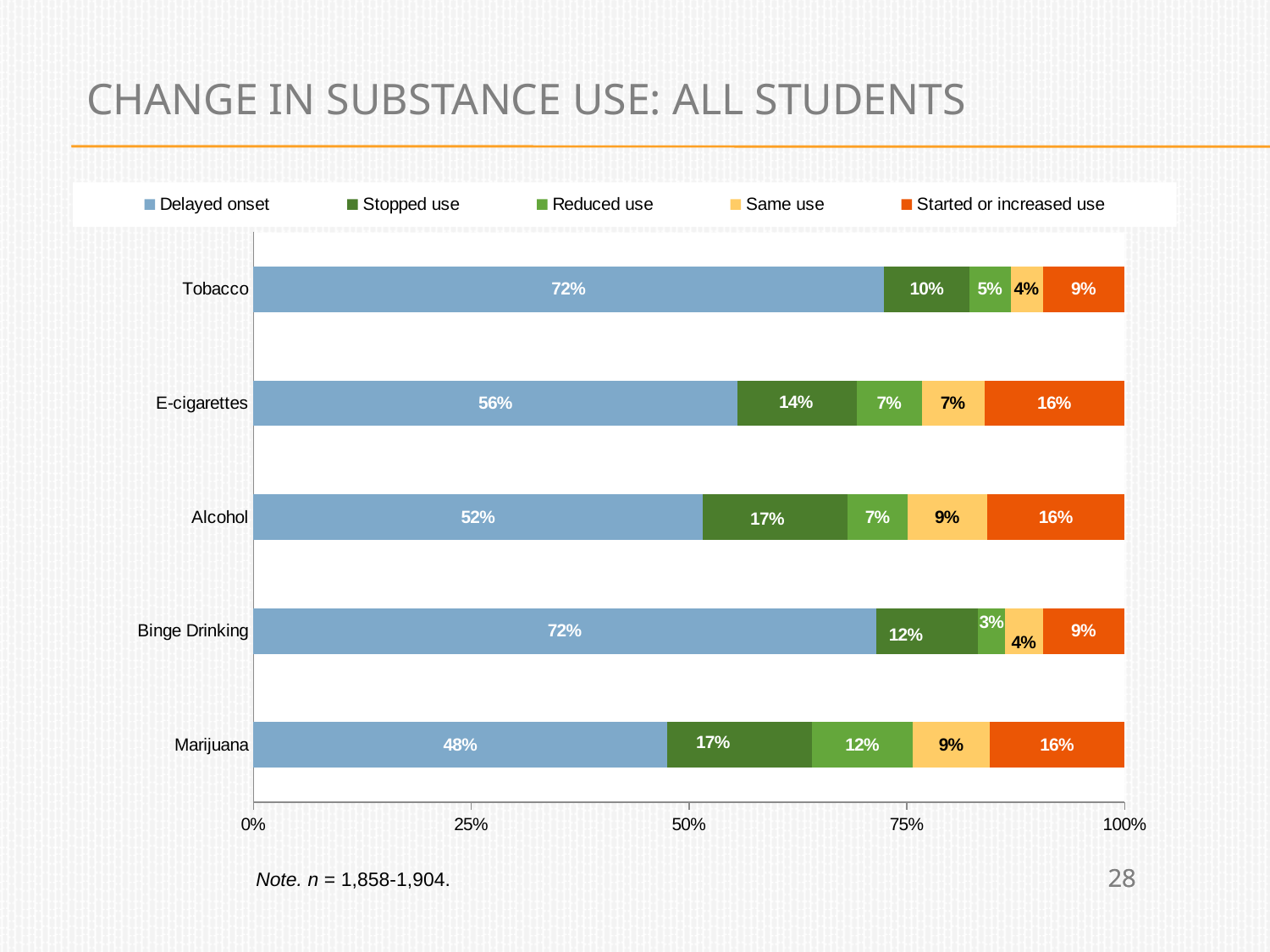
What is the difference in 'Delayed onset' between Tobacco and Marijuana? 24 percentage points How many substances are shown on the chart? 5 What colour represents 'Started or increased use' in the legend? Orange How many series does the legend list? 5 What percentage of students reported 'Stopped use' for Alcohol? 17% Which substance has the highest 'Reduced use' percentage? Marijuana Which has a larger 'Stopped use' value, E-cigarettes or Tobacco? E-cigarettes What kind of chart is shown on the slide? Stacked bar chart What is the value for 'Started or increased use' for E-cigarettes? 16% What is the 'Same use' value for Binge Drinking? 4% What percentage of students reported delayed onset for Marijuana? 48% Which substance has the lowest 'Delayed onset' percentage? Marijuana